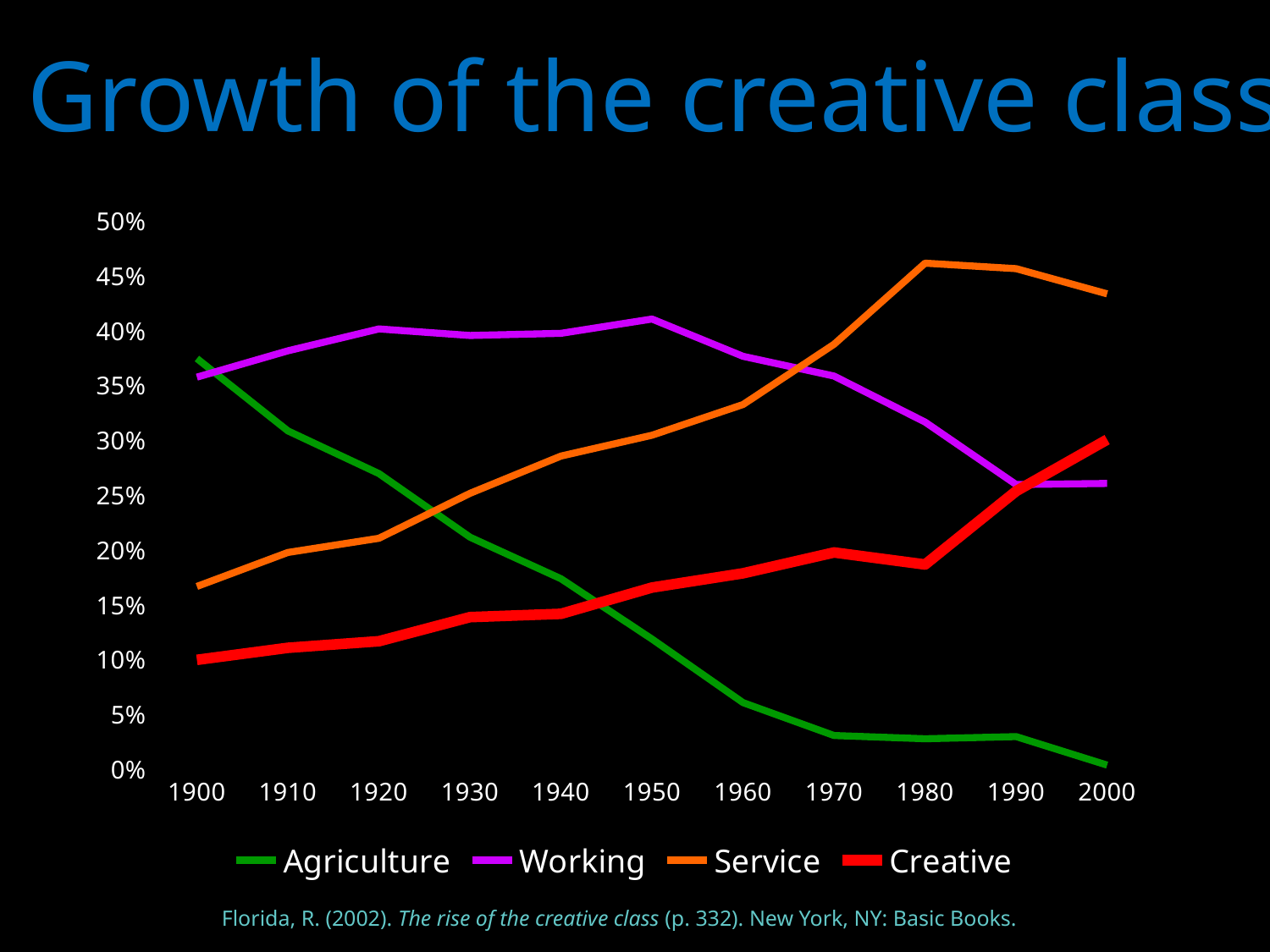
Which series has the lowest value in 2000? Agriculture Is the value for Working in 1920 greater or less than 35%? greater Does the Service line rise or fall from 1900 to 1980? rise Is the value for Agriculture in 1900 greater or less than 35%? greater Is the value for Service in 1980 greater or less than 40%? greater What kind of chart is shown on the slide? line chart Which series has the highest value in 1950? Working How many series does the legend list? 4 In 2000, which is larger, the Service value or the Working value? Service How many years are marked along the x axis? 11 Does the Agriculture line rise or fall from 1900 to 2000? fall